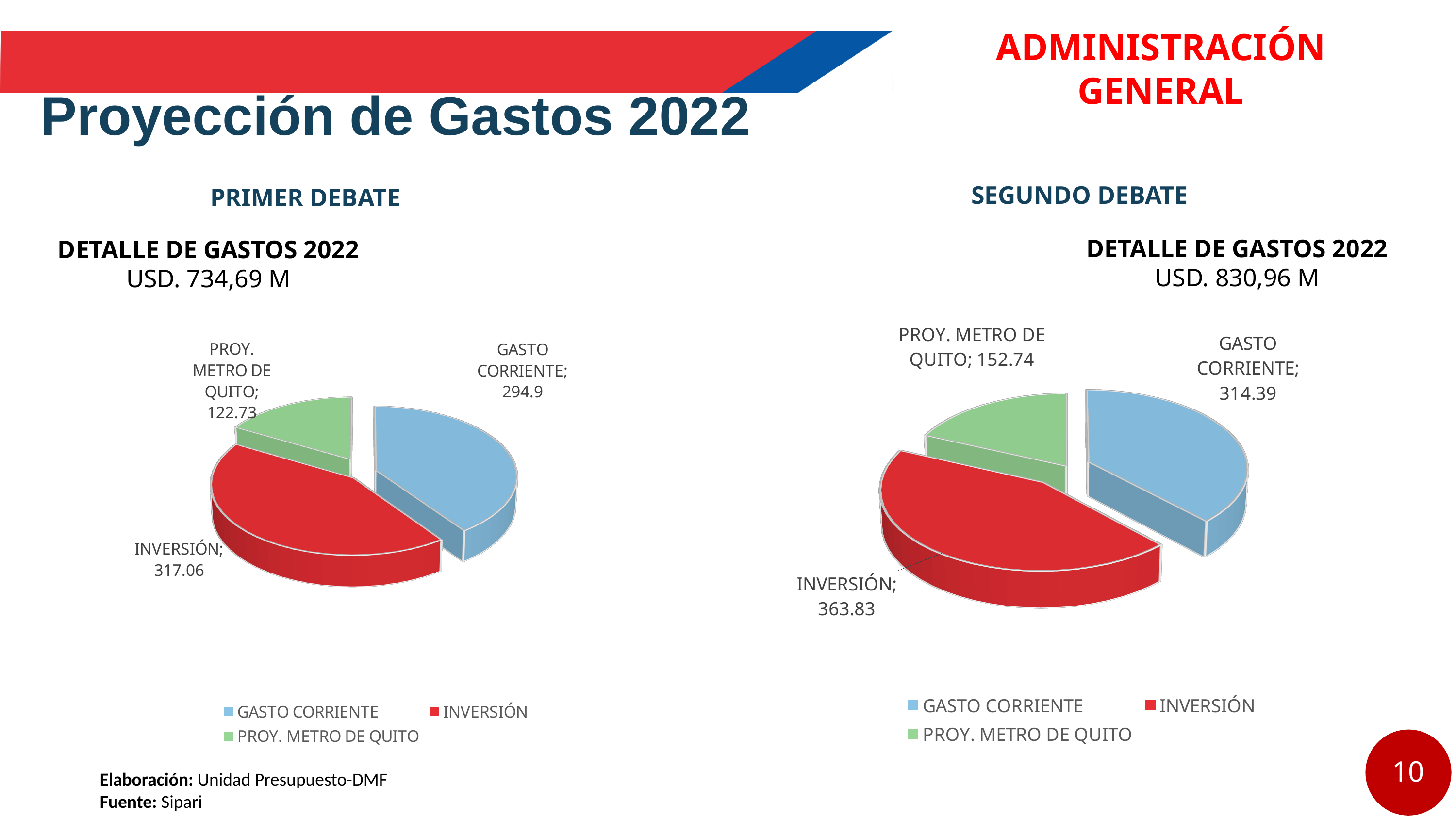
Is the value for INVERSIÓN larger in the PRIMER DEBATE chart or the SEGUNDO DEBATE chart? SEGUNDO DEBATE What type of chart is used for the SEGUNDO DEBATE data? Pie chart In the SEGUNDO DEBATE pie chart, what is the value for PROY. METRO DE QUITO? 152.74 In the SEGUNDO DEBATE pie chart, what is the value for GASTO CORRIENTE? 314.39 In the PRIMER DEBATE pie chart, what is the difference between INVERSIÓN and GASTO CORRIENTE? 22.16 In the PRIMER DEBATE pie chart, what is the value for INVERSIÓN? 317.06 In the SEGUNDO DEBATE pie chart, what is the difference between INVERSIÓN and GASTO CORRIENTE? 49.44 In the SEGUNDO DEBATE pie chart, which colour represents INVERSIÓN? Red In the SEGUNDO DEBATE pie chart, which category has the smallest value? PROY. METRO DE QUITO How many categories does the PRIMER DEBATE pie chart show? 3 In the PRIMER DEBATE pie chart, which category has the largest value? INVERSIÓN In the PRIMER DEBATE pie chart, what is the value for PROY. METRO DE QUITO? 122.73